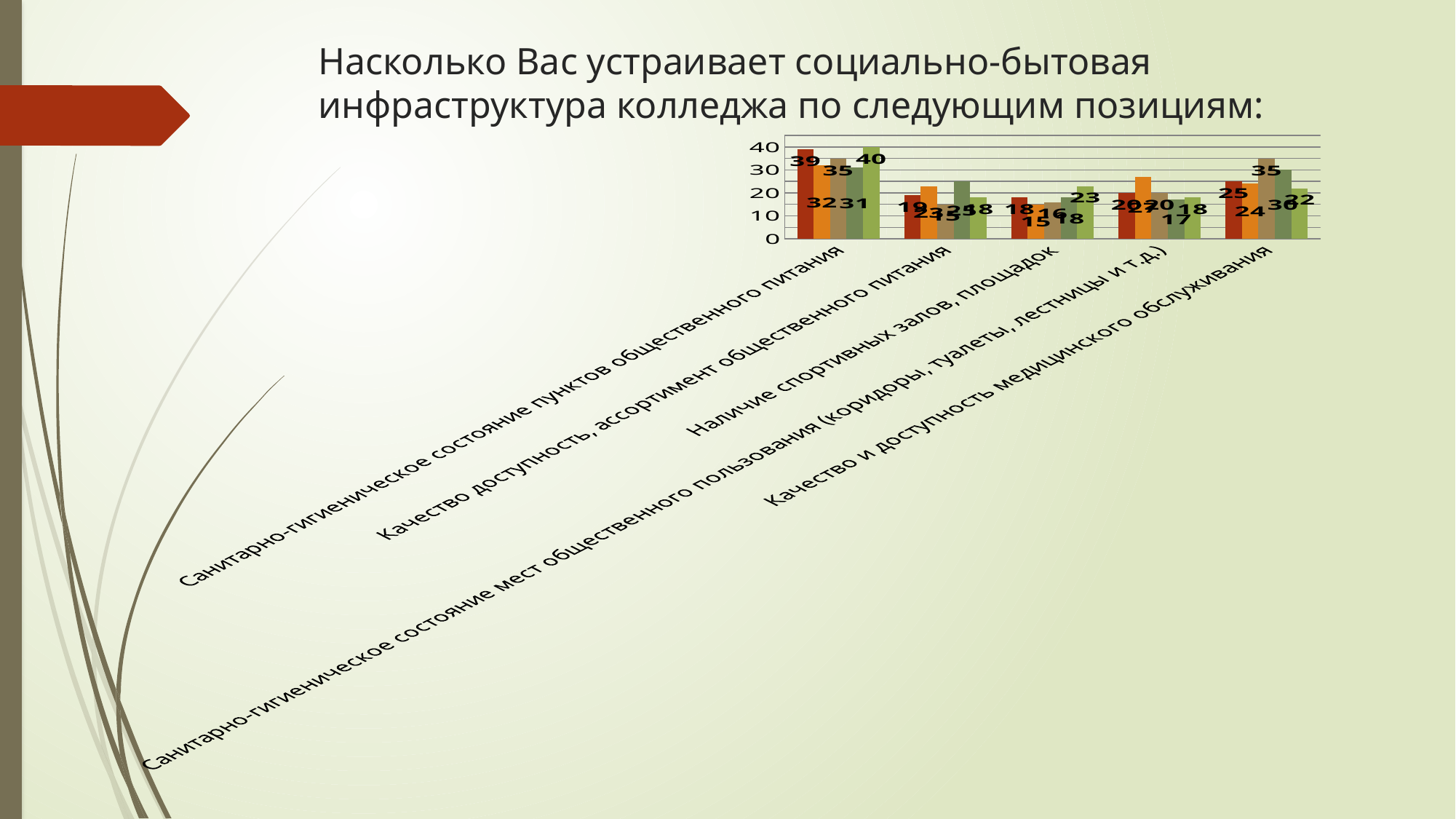
What is the title of the slide containing the chart? Насколько Вас устраивает социально-бытовая инфраструктура колледжа по следующим позициям: What is the value of the first (dark red) bar in the category 'Качество доступность, ассортимент общественного питания'? 19 What is the maximum value shown on the vertical axis of the chart? 40 Is the tallest bar in the category 'Качество и доступность медицинского обслуживания' greater or less than 30? greater Which category contains the tallest bar in the chart? Санитарно-гигиеническое состояние пунктов общественного питания Is the tallest bar in the category 'Наличие спортивных залов, площадок' greater or less than 30? less What is the highest data label shown in the category 'Санитарно-гигиеническое состояние пунктов общественного питания'? 40 Which category has the taller tallest bar: 'Санитарно-гигиеническое состояние пунктов общественного питания' or 'Наличие спортивных залов, площадок'? Санитарно-гигиеническое состояние пунктов общественного питания What is the value of the first (dark red) bar in the category 'Санитарно-гигиеническое состояние пунктов общественного питания'? 39 What kind of chart is shown on the slide? bar chart How many categories are shown on the x axis of the chart? 5 What is the value of the first (dark red) bar in the category 'Качество и доступность медицинского обслуживания'? 25